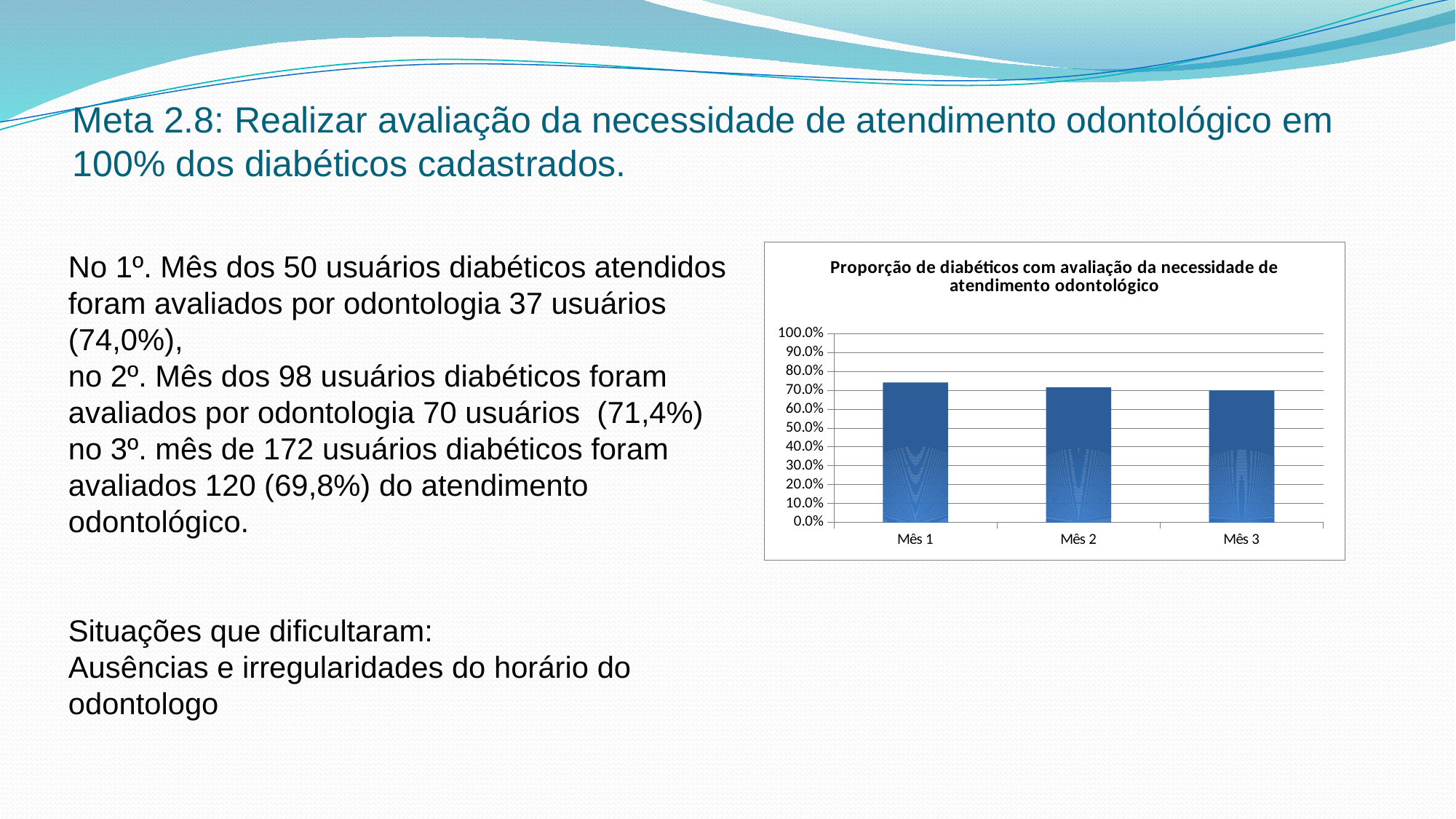
Which month has the highest proportion on the chart? Mês 1 What kind of chart is shown on the slide? bar chart Is the value for Mês 3 greater or less than 80.0%? less Is the value for Mês 1 greater or less than 70.0%? greater Is the value for Mês 3 greater or less than 50.0%? greater Do the values rise or fall from Mês 1 to Mês 3? fall What is the title of the chart? Proporção de diabéticos com avaliação da necessidade de atendimento odontológico What is the highest value shown on the chart's vertical axis? 100.0% Which is larger, the value for Mês 1 or the value for Mês 3? Mês 1 How many categories (months) are plotted on the chart? 3